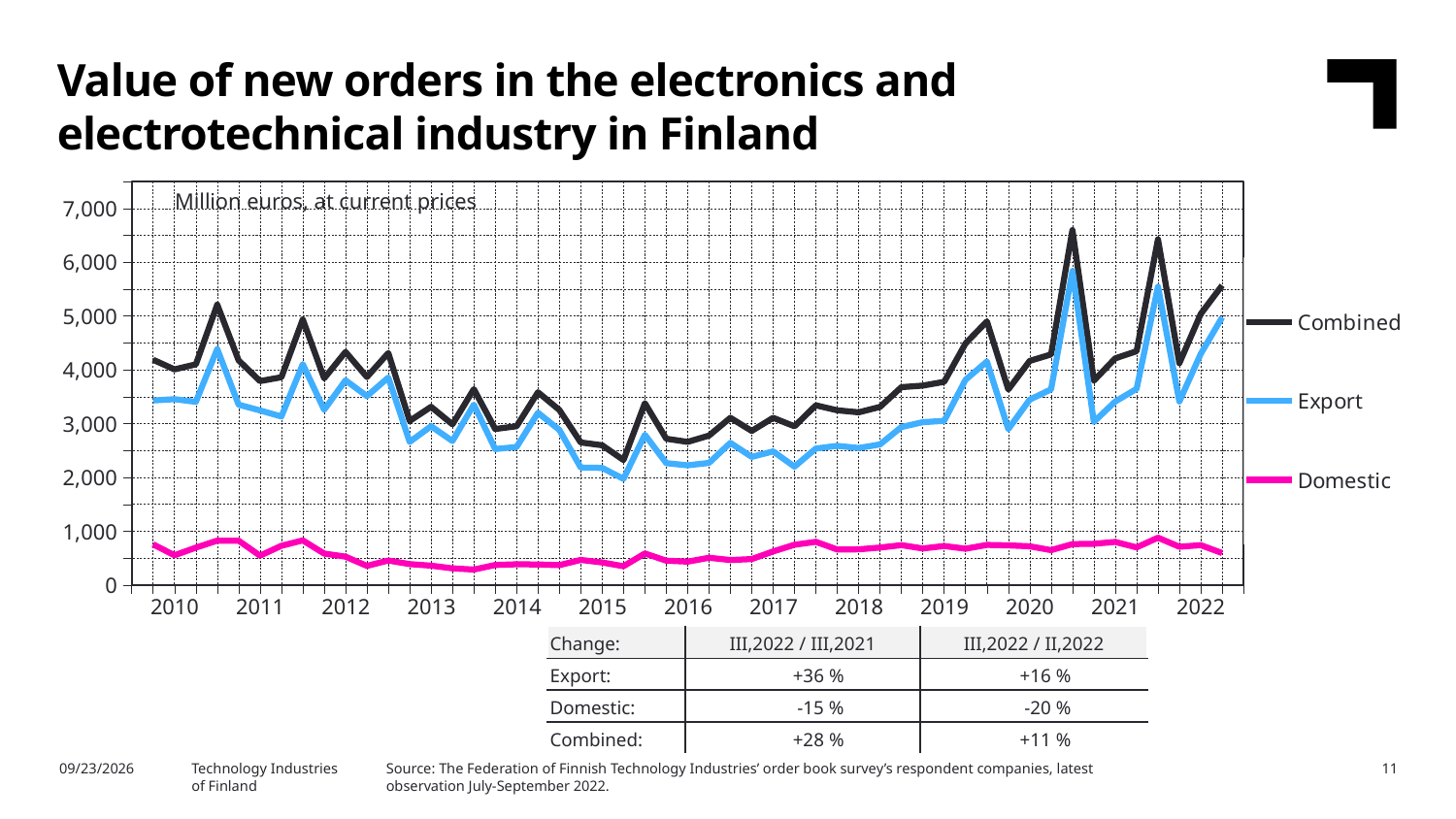
How many series does the legend list? 3 Is the Domestic value in 2022 greater or less than 1,000? less Is the lowest Combined value in 2015 greater or less than 3,000? less Which series has the highest values throughout the chart? Combined Which series has the lowest values throughout the chart? Domestic What kind of chart is shown on the slide? line chart What colour is the Export line in the chart? blue Does the Combined series generally rise or fall between 2015 and 2020? rise Is the peak Combined value in 2020 greater or less than 6,000? greater What unit is stated for the values on the chart? Million euros, at current prices Which series is larger in 2022, Export or Domestic? Export